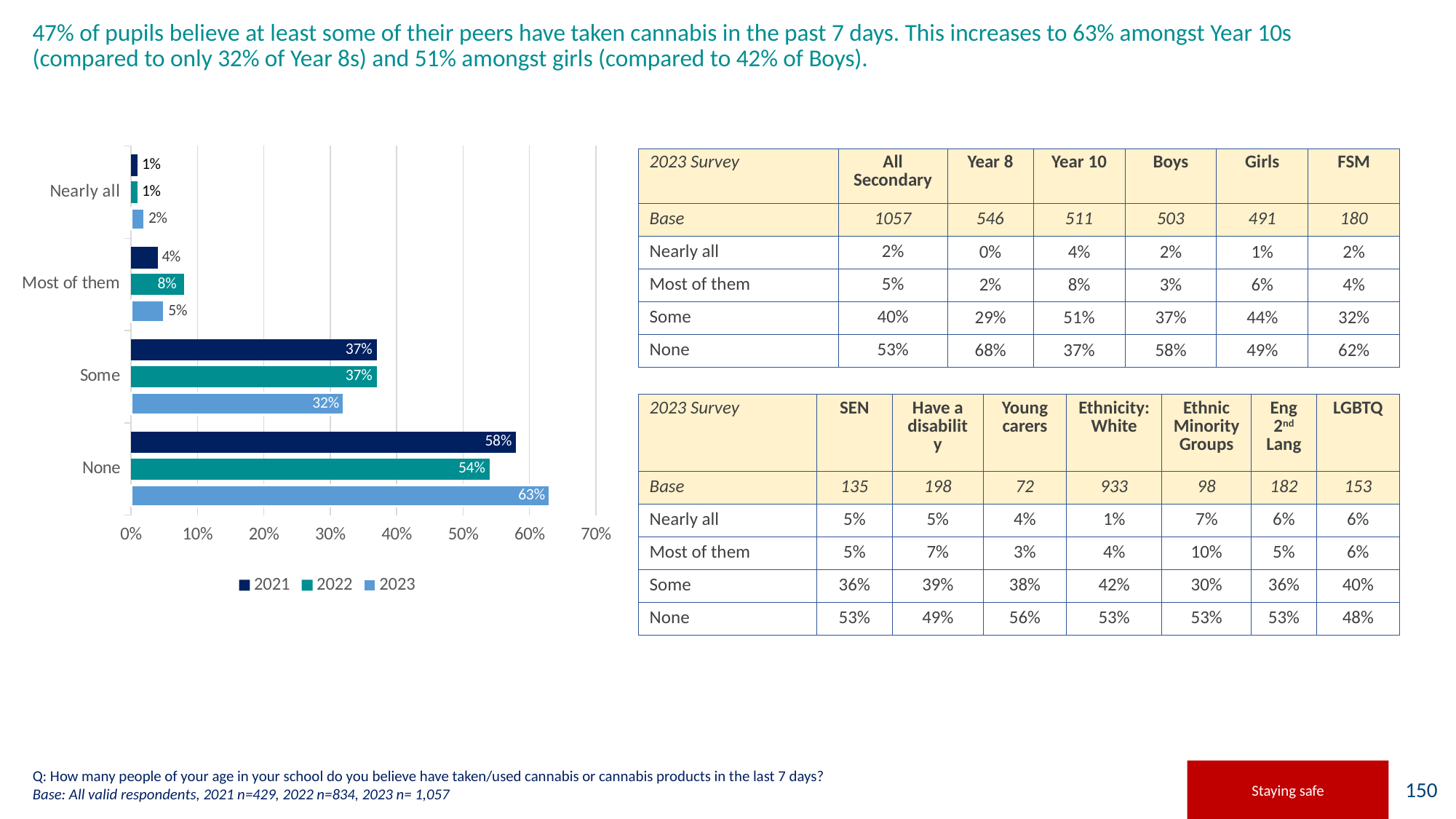
How many series does the chart legend list? 3 Which is larger in the chart: the 2021 value for None or the 2022 value for None? 2021 What kind of chart is shown on the slide? bar chart What is the difference between the 2021 and 2023 values for Some in the chart? 5% Which category has the highest 2023 value in the chart? None What is the 2022 value for Most of them in the chart? 8% What is the 2023 value for None in the chart? 63% How many categories are shown on the chart? 4 What is the difference between the 2023 and 2022 values for None in the chart? 9% What is the 2021 value for Some in the chart? 37% Which category has the lowest 2021 value in the chart? Nearly all Which series is shown in the lightest blue colour in the chart legend? 2023